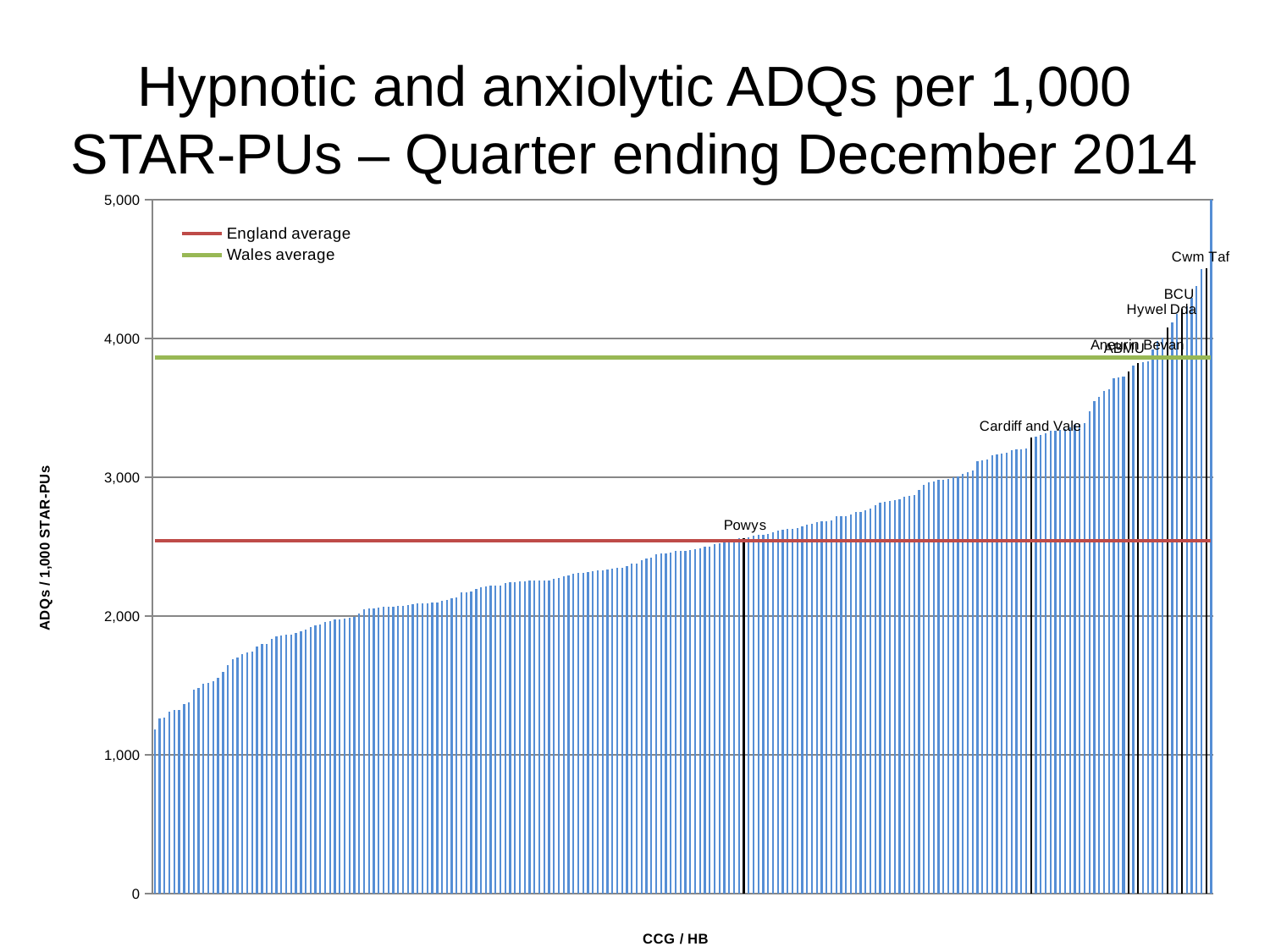
Which is higher, the Wales average or the England average? Wales average What is the label on the x axis of the chart? CCG / HB Is the England average line greater or less than 3,000? less What kind of chart is shown on the slide? Bar chart Is the value for Cwm Taf greater or less than 4,000? greater Is the value for Powys greater or less than 3,000? less Which labelled health board has the lowest value on the chart? Powys How many entries does the chart legend list? 2 Do the bar values rise or fall from left to right along the x axis? Rise Which has the larger value, Cwm Taf or Cardiff and Vale? Cwm Taf Which labelled health board has the highest value on the chart? Cwm Taf